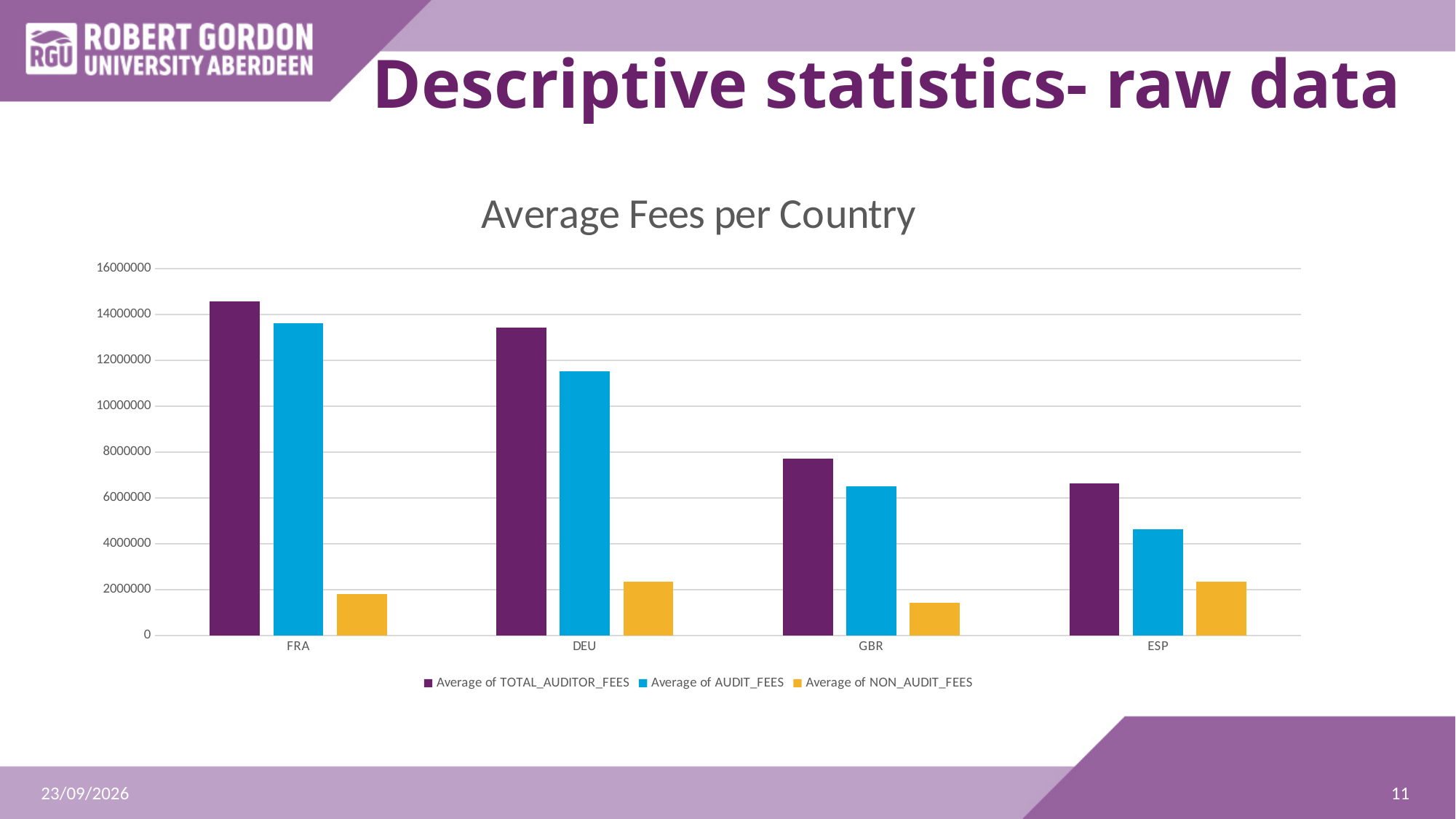
Do the Average of TOTAL_AUDITOR_FEES values rise or fall from FRA to ESP along the x axis? fall Is the Average of TOTAL_AUDITOR_FEES for FRA greater or less than 14000000? greater How many countries are shown on the x axis? 4 Which country has the highest Average of TOTAL_AUDITOR_FEES? FRA What colour represents Average of NON_AUDIT_FEES in the chart? yellow Is the Average of AUDIT_FEES for DEU greater or less than 12000000? less What is the title of the chart? Average Fees per Country How many series does the legend list? 3 Which country has the lowest Average of AUDIT_FEES? ESP Which is larger, the Average of AUDIT_FEES for GBR or for ESP? GBR What type of chart is shown on the slide? bar chart Is the Average of NON_AUDIT_FEES for GBR greater or less than 2000000? less